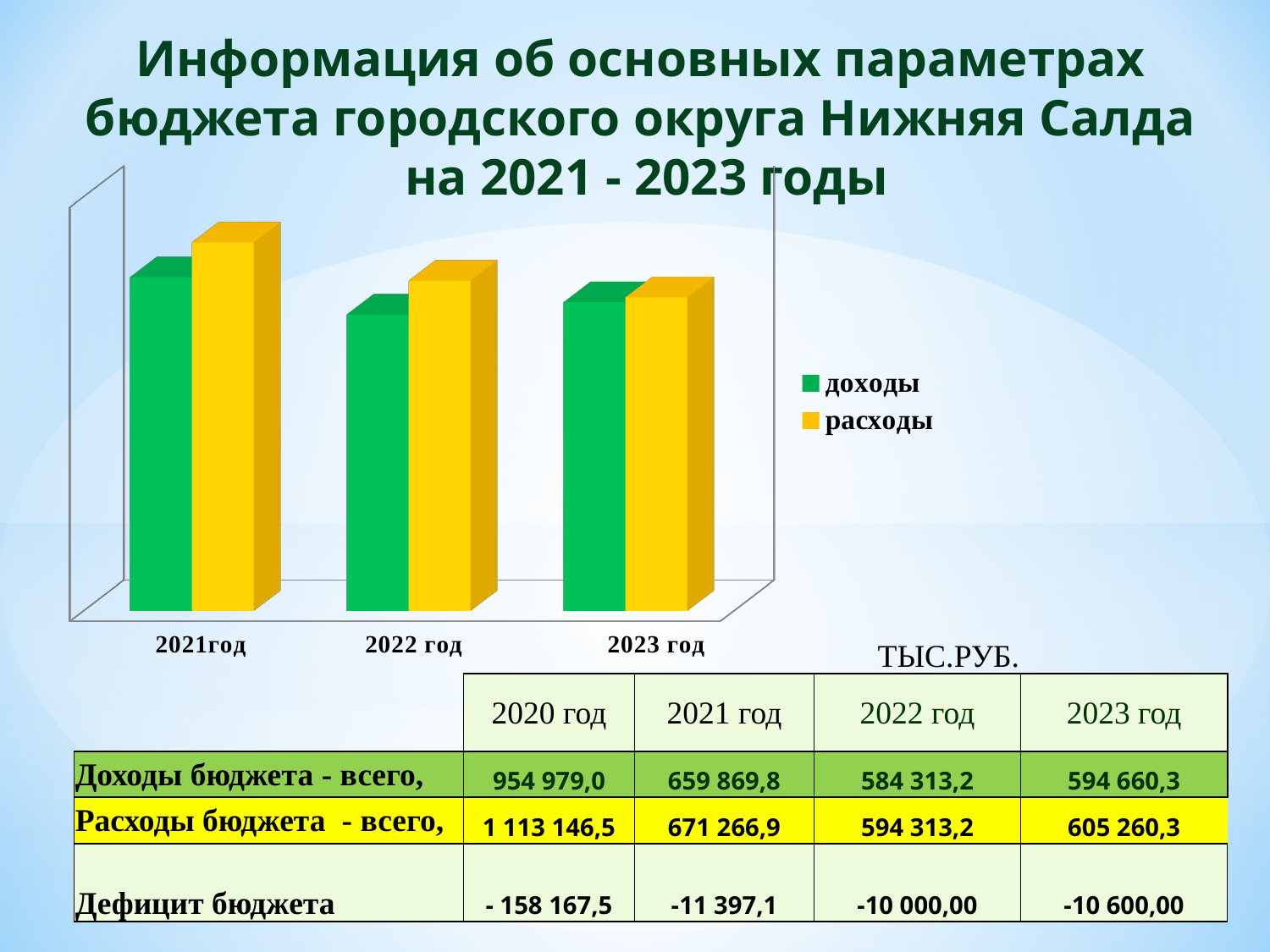
According to the table, what is the value of расходы for 2022 год? 594 313,2 Which colour represents расходы in the chart? yellow How many series does the chart legend list? 2 What kind of chart is shown on the slide? bar chart What are the two series named in the chart legend? доходы, расходы In which year is доходы highest in the chart? 2021год Does расходы rise or fall from 2021 год to 2023 год? fall In 2021 год, which is larger, доходы or расходы? расходы How many year categories are plotted in the chart? 3 According to the table, what is the value of доходы for 2021 год? 659 869,8 In which year is расходы lowest in the chart? 2023 год According to the table, what is the value of расходы for 2023 год? 605 260,3